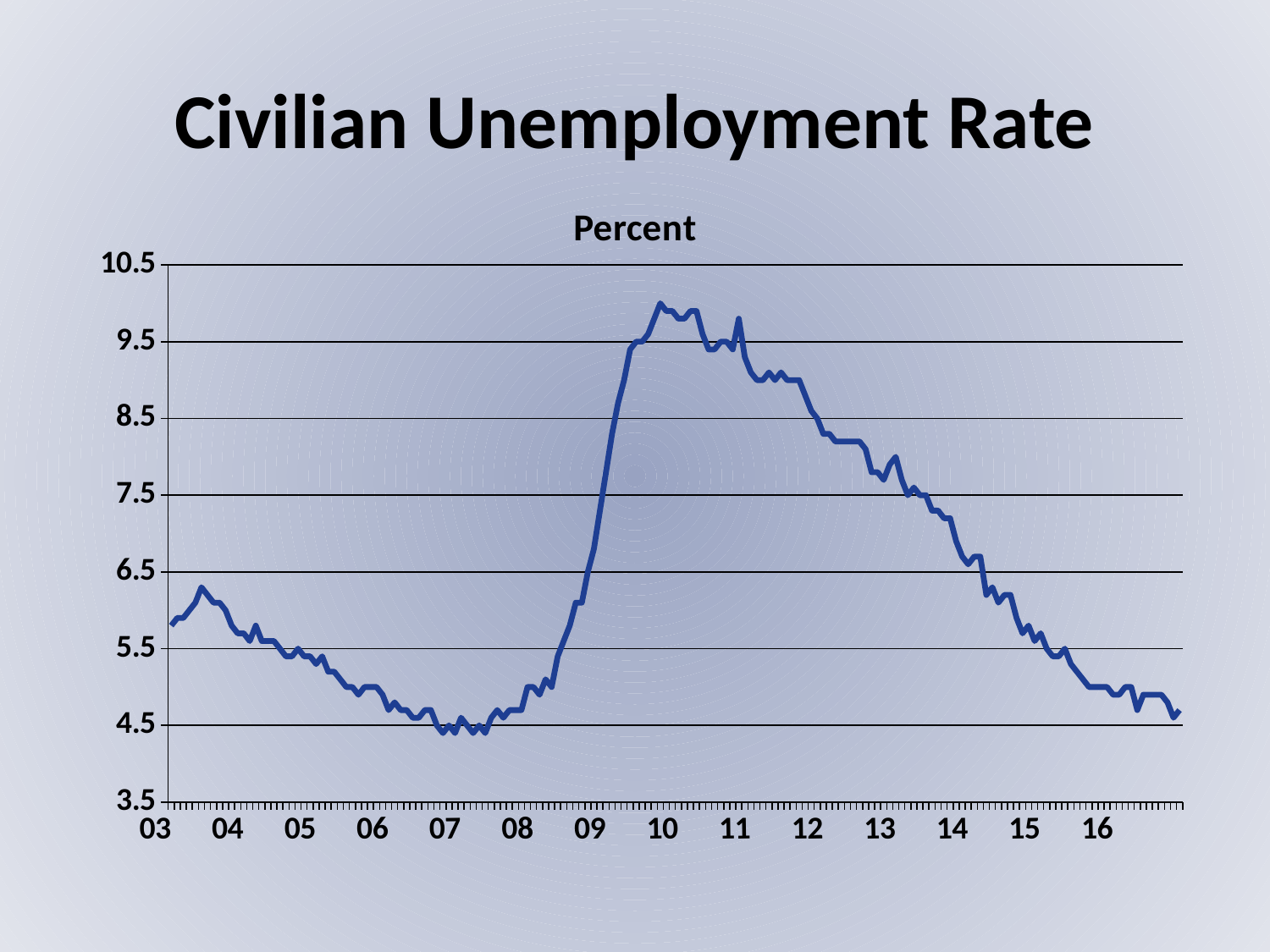
Does the unemployment rate rise or fall between the 11 and 16 marks on the x axis? fall Is the unemployment rate at the 14 mark on the x axis greater or less than 7.5? less Is the unemployment rate at the 07 mark on the x axis greater or less than 5.5? less Is the unemployment rate at the 10 mark on the x axis greater or less than 9.5? greater What unit label is shown above the chart's vertical axis? Percent How many data series are plotted on the chart? 1 How many year labels are shown along the x axis? 14 What kind of chart is shown on the slide? line chart What is the title of the chart? Civilian Unemployment Rate Around which year label does the unemployment rate reach its highest point? 10